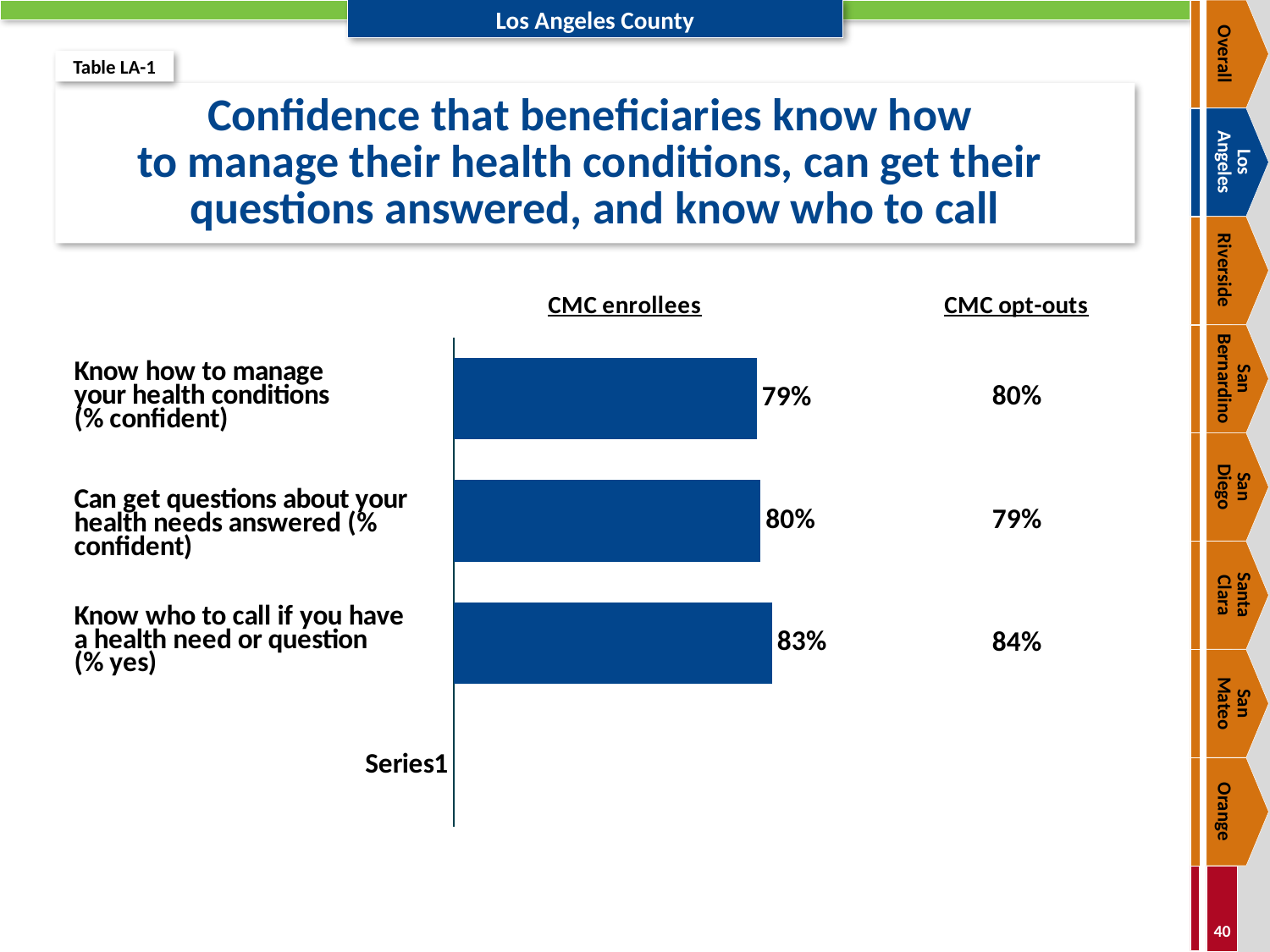
For 'Can get questions about your health needs answered', which is larger: the CMC enrollees value or the CMC opt-outs value? CMC enrollees What is the difference between the CMC enrollees values for 'Know who to call if you have a health need or question' and 'Know how to manage your health conditions'? 4% For 'Know who to call if you have a health need or question', which is larger: the CMC enrollees value or the CMC opt-outs value? CMC opt-outs What is the CMC enrollees value for 'Can get questions about your health needs answered (% confident)'? 80% What is the CMC opt-outs value shown for 'Know who to call if you have a health need or question (% yes)'? 84% Which item has the lowest CMC enrollees value? Know how to manage your health conditions (% confident) What is the title of the chart on the slide? Confidence that beneficiaries know how to manage their health conditions, can get their questions answered, and know who to call Which item has the highest CMC enrollees value? Know who to call if you have a health need or question (% yes) What type of chart is shown on the slide? Bar chart How many bars are plotted in the chart? 3 What is the CMC enrollees value for 'Know who to call if you have a health need or question (% yes)'? 83% What is the CMC enrollees value for 'Know how to manage your health conditions (% confident)'? 79%